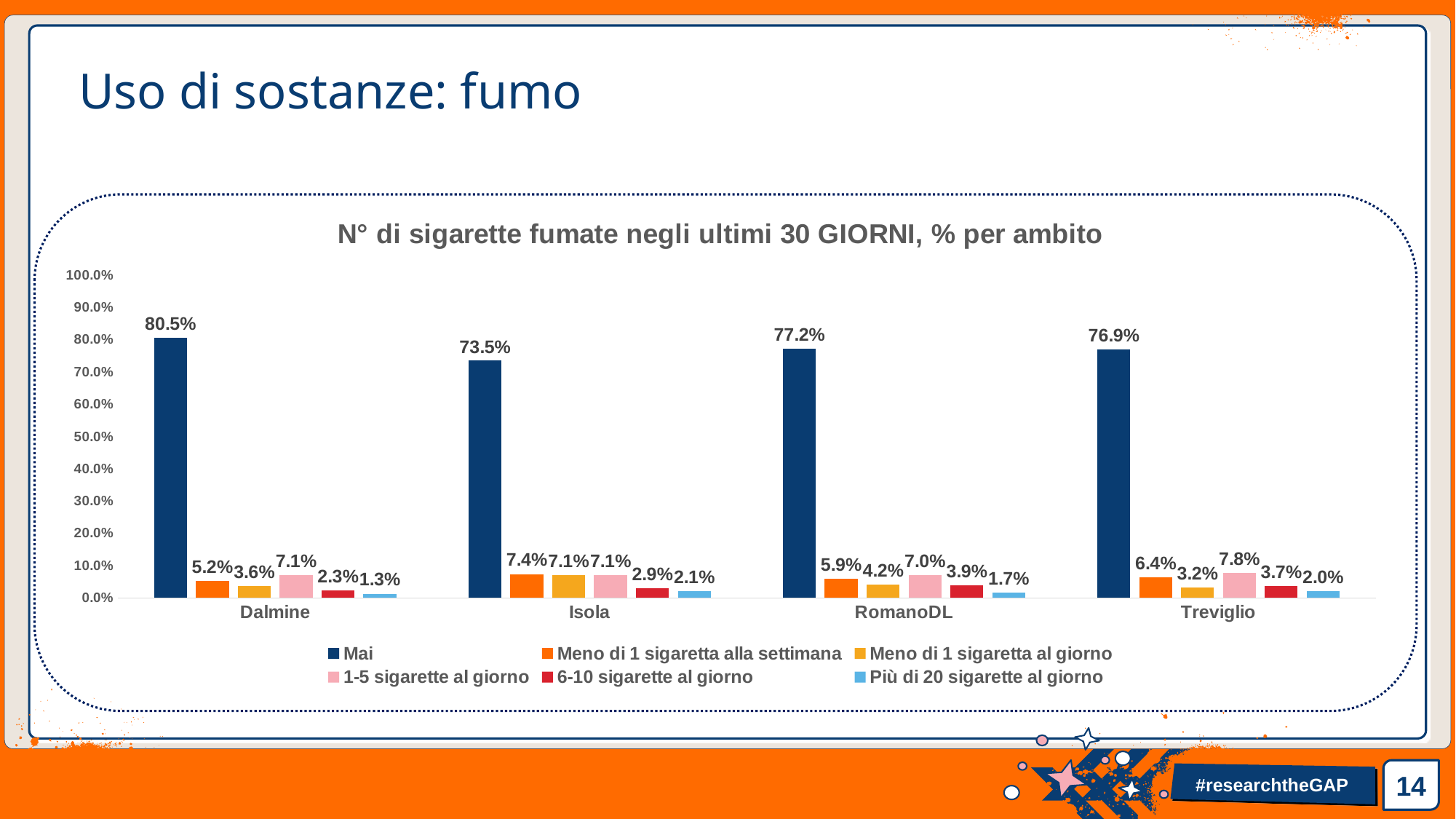
What is the difference between the "Mai" values for Dalmine and Isola? 7.0% What is the value for "1-5 sigarette al giorno" in Treviglio? 7.8% How many categories (ambiti) are shown on the x axis? 4 How many series does the legend list? 6 Which category has the highest value for "Mai"? Dalmine What is the value for "Più di 20 sigarette al giorno" in RomanoDL? 1.7% What kind of chart is shown on the slide? Bar chart What is the value for "Mai" in Dalmine? 80.5% What is the title of the chart? N° di sigarette fumate negli ultimi 30 GIORNI, % per ambito Is the value for "Mai" in RomanoDL greater or less than 70.0%? greater Which is larger: "Meno di 1 sigaretta alla settimana" in Isola or in Treviglio? Isola Which category has the lowest value for "Mai"? Isola